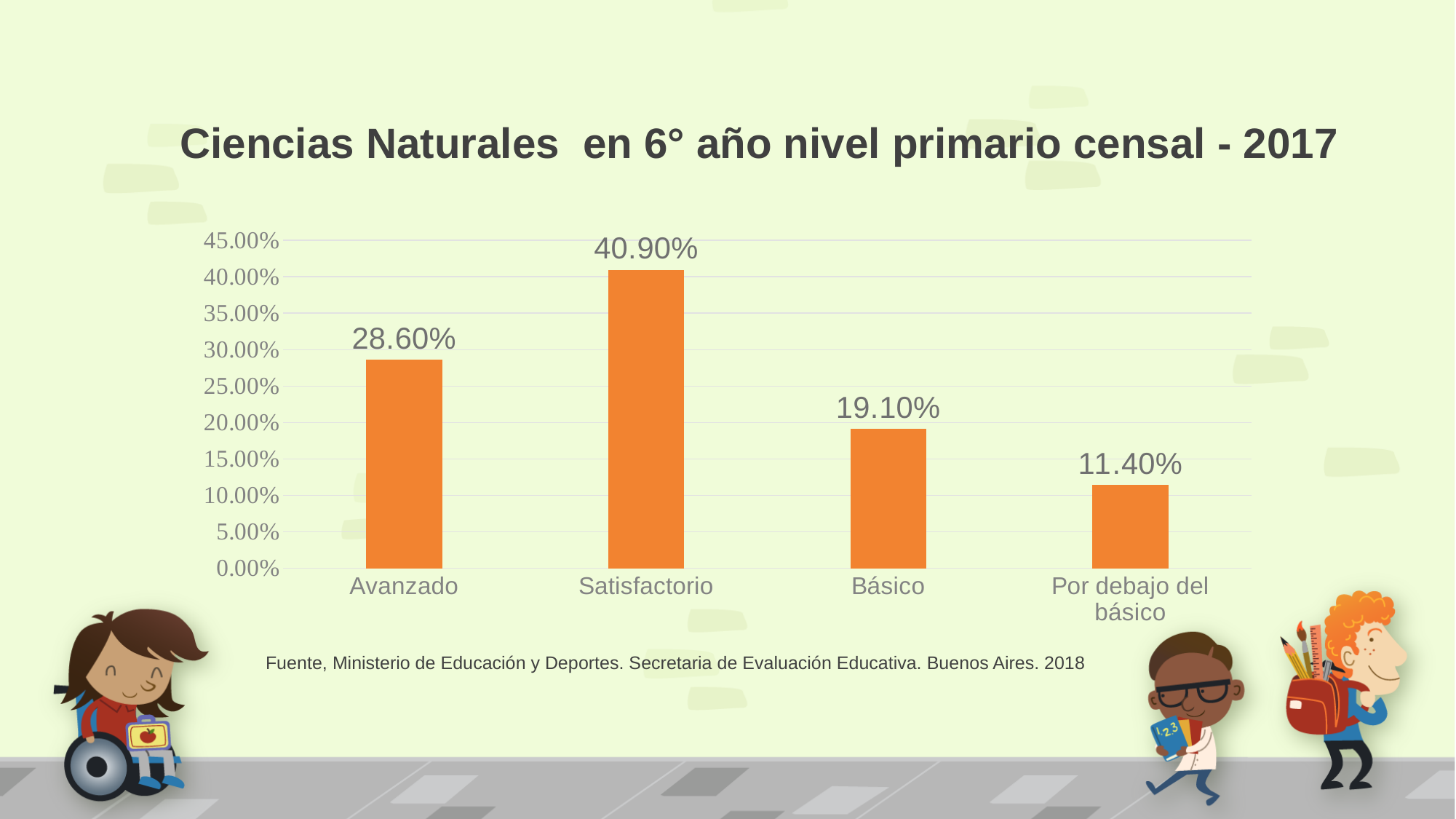
What is the difference between the values for Satisfactorio and Avanzado? 12.30% How many categories are shown on the x axis? 4 What is the value for Por debajo del básico? 11.40% What is the value for Avanzado? 28.60% Which category has the lowest value? Por debajo del básico What is the value for Básico? 19.10% What kind of chart is shown on the slide? Bar chart Which category has the highest value? Satisfactorio What is the title of the chart? Ciencias Naturales en 6° año nivel primario censal - 2017 What is the difference between the values for Básico and Por debajo del básico? 7.70% What is the value for Satisfactorio? 40.90% Which is larger, the value for Avanzado or the value for Básico? Avanzado